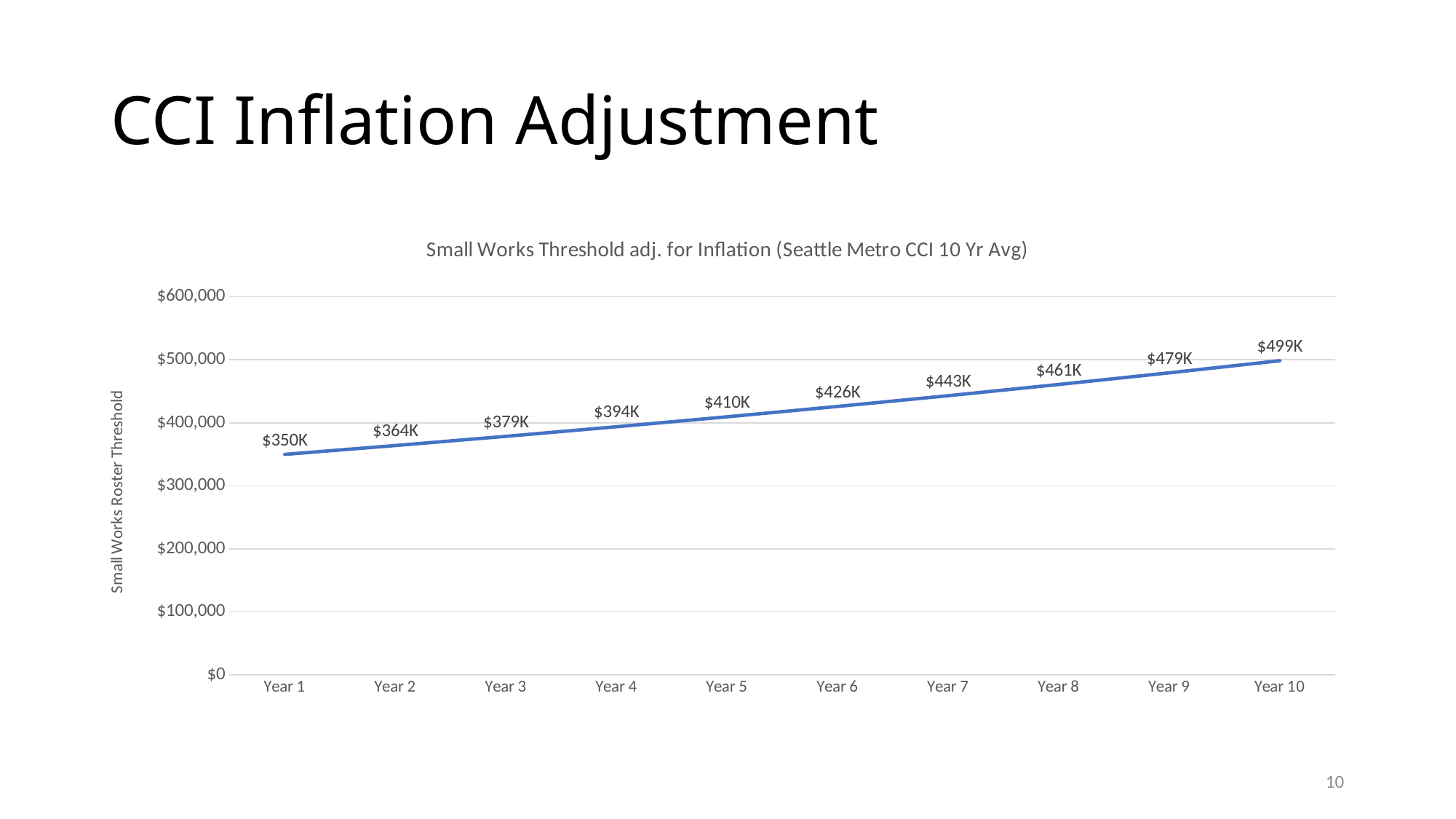
What is the value shown for Year 5? $410K Which year has the lowest threshold value? Year 1 What is the value shown for Year 10? $499K Is the value for Year 8 greater or less than $400,000? greater What kind of chart is shown on the slide? Line chart Which year has the highest threshold value? Year 10 Which is larger, the value for Year 7 or the value for Year 4? Year 7 What is the Small Works Roster Threshold value for Year 1? $350K How many years are plotted on the x axis? 10 What is the title of the chart? Small Works Threshold adj. for Inflation (Seattle Metro CCI 10 Yr Avg) What is the difference between the Year 10 value and the Year 1 value? $149K Do the values rise or fall from Year 1 to Year 10? Rise